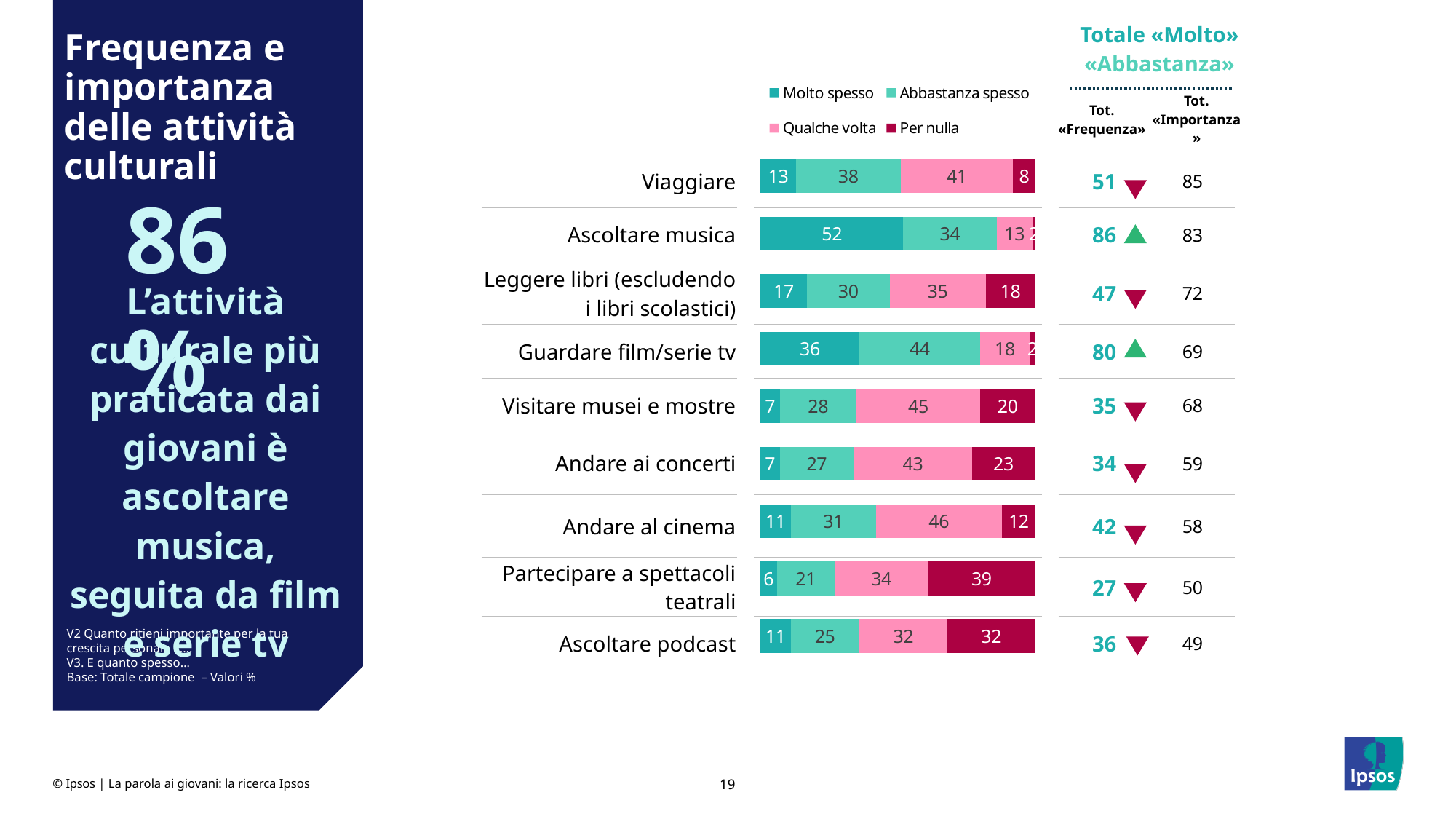
What is the total of the stacked bar for Viaggiare? 100 What is the 'Per nulla' value for Partecipare a spettacoli teatrali? 39 Which legend entry is shown in the darkest red/magenta colour? Per nulla What is the 'Qualche volta' value for Andare al cinema? 46 Which is larger: the 'Per nulla' value for Andare ai concerti or for Visitare musei e mostre? Andare ai concerti Which activity has the highest 'Molto spesso' value? Ascoltare musica What is the 'Molto spesso' value for Ascoltare musica? 52 Which activity has the lowest 'Molto spesso' value? Partecipare a spettacoli teatrali How many series does the chart legend list? 4 How many activities (categories) are plotted in the chart? 9 What is the difference between the 'Abbastanza spesso' values for Guardare film/serie tv and Viaggiare? 6 What type of chart is shown on the slide? stacked bar chart